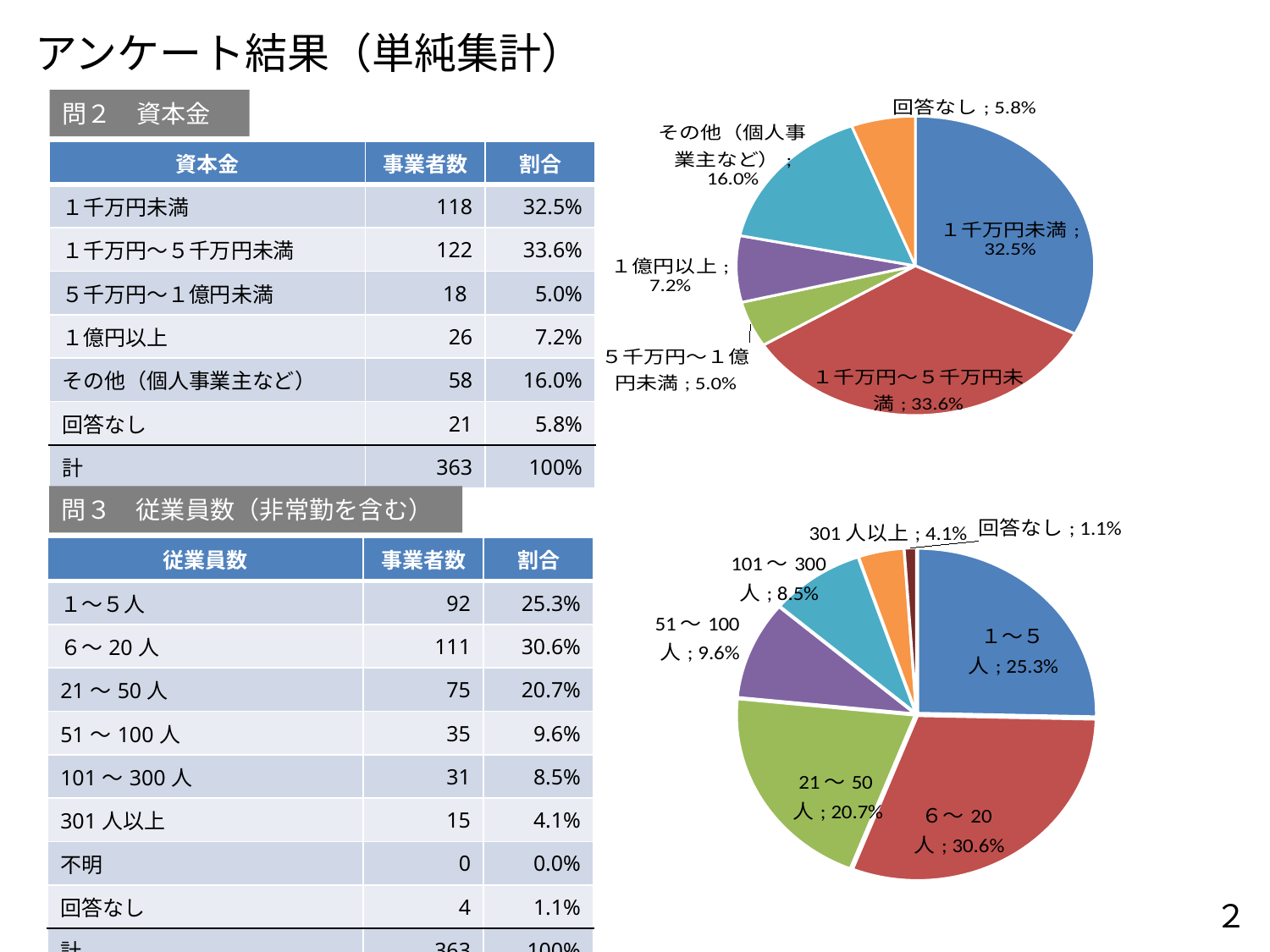
In the bottom pie chart, what is the share for 301人以上? 4.1% What kind of chart is the bottom chart on the slide? Pie chart In the top pie chart, which category has the largest share? 1千万円～5千万円未満 In the top pie chart, what is the difference between the shares for 1億円以上 and 回答なし? 1.4% In the top pie chart, what is the share for その他（個人事業主など）? 16.0% In the bottom pie chart, which category has the smallest share? 回答なし In the bottom pie chart, what is the share for 6～20人? 30.6% In the bottom pie chart, which is larger: the share for 51～100人 or the share for 101～300人? 51～100人 In the bottom pie chart, what is the difference between the shares for 1～5人 and 21～50人? 4.6% In the top pie chart, which category has the smallest share? 5千万円～1億円未満 How many slices does the top pie chart have? 6 In the top pie chart, what is the share for 1千万円未満? 32.5%